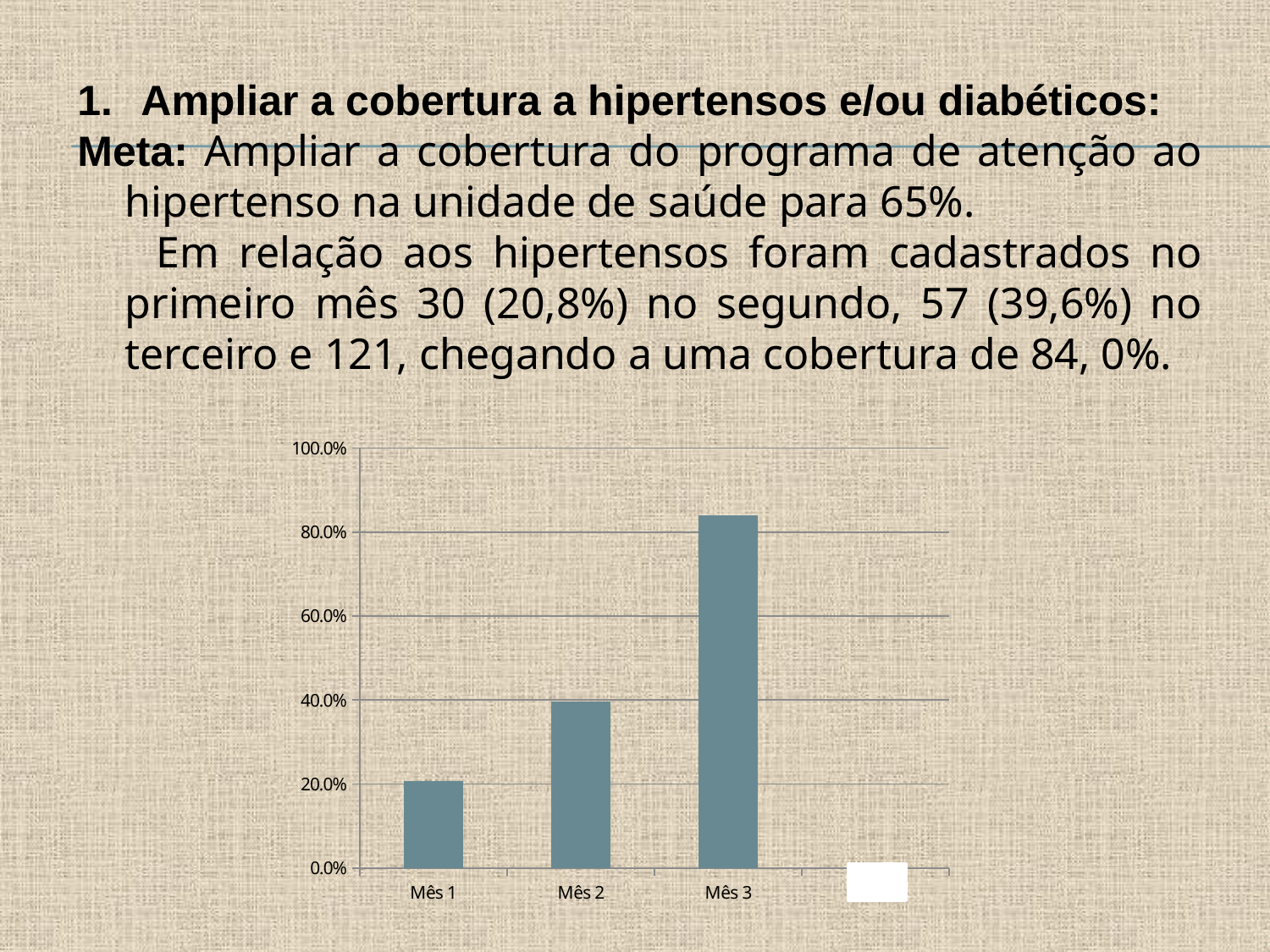
Is the value for Mês 1 greater or less than 40.0%? less How many bars are plotted in the chart? 3 Do the values rise or fall from Mês 1 to Mês 3? rise What is the highest value shown on the vertical axis of the chart? 100.0% Which is larger, the value for Mês 1 or the value for Mês 2? Mês 2 Which month has the lowest bar in the chart? Mês 1 Is the value for Mês 2 greater or less than 20.0%? greater Is the value for Mês 3 greater or less than 100.0%? less Which month has the highest bar in the chart? Mês 3 What kind of chart is shown on the slide? bar chart Which is larger, the value for Mês 2 or the value for Mês 3? Mês 3